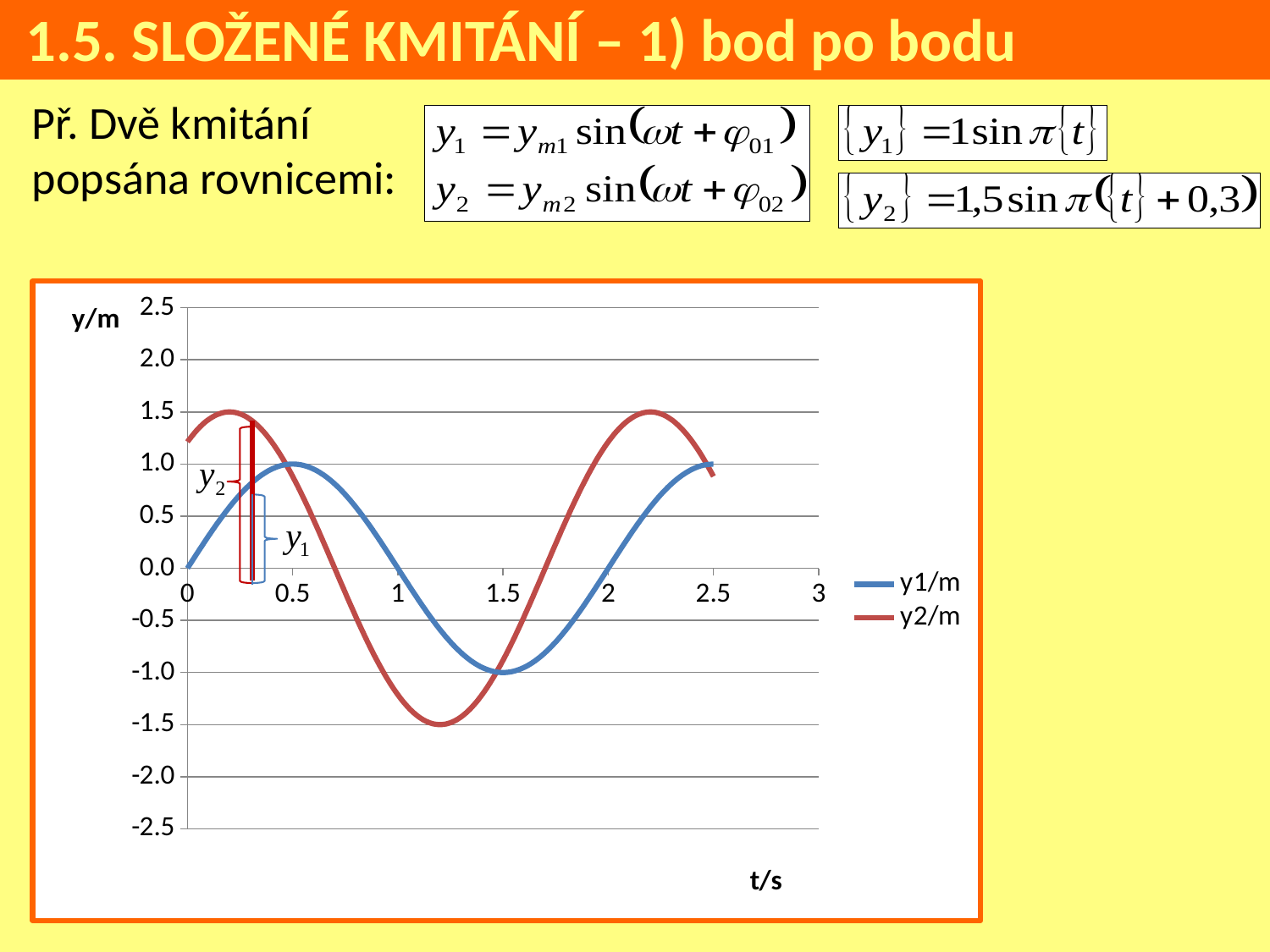
What is the label of the horizontal axis of the chart? t/s What kind of chart is shown on the slide? line chart What is the maximum value reached by the y1/m curve? 1.0 Is the value of y2/m at t = 0 greater or less than 1.0? greater Does the y1/m curve rise or fall between t = 0 and t = 0.5? rise What is the minimum value reached by the y1/m curve? -1.0 What is the minimum value reached by the y2/m curve? -1.5 What is the value of y1/m at t = 0? 0.0 How many series does the chart legend list? 2 What are the two series names listed in the chart legend? y1/m and y2/m Which series reaches a higher peak value, y1/m or y2/m? y2/m What is the maximum value reached by the y2/m curve? 1.5